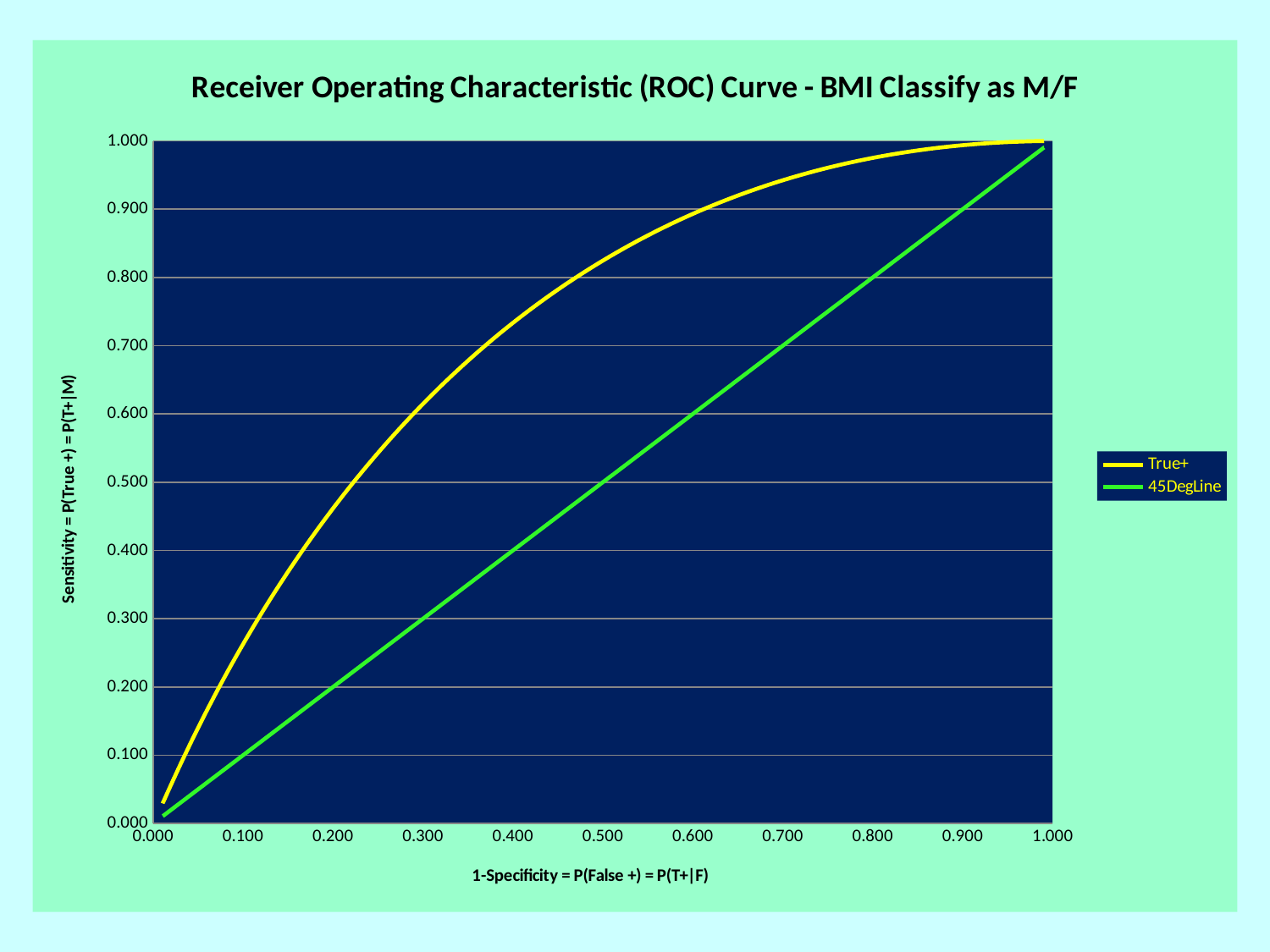
What kind of chart is shown on the slide? line chart Which series is drawn in yellow according to the legend? True+ Is the value of the True+ series at x = 0.200 greater or less than 0.400? greater Is the value of the True+ series at x = 0.500 greater or less than 0.700? greater How many series does the legend list? 2 What is the title of the chart? Receiver Operating Characteristic (ROC) Curve - BMI Classify as M/F At x = 0.800, which series has the lower value, True+ or 45DegLine? 45DegLine Does the 45DegLine series rise or fall as the x axis increases? rise Is the value of the 45DegLine series at x = 0.300 greater or less than 0.400? less At x = 0.500, which series has the higher value, True+ or 45DegLine? True+ Does the True+ series rise or fall as the x axis increases? rise